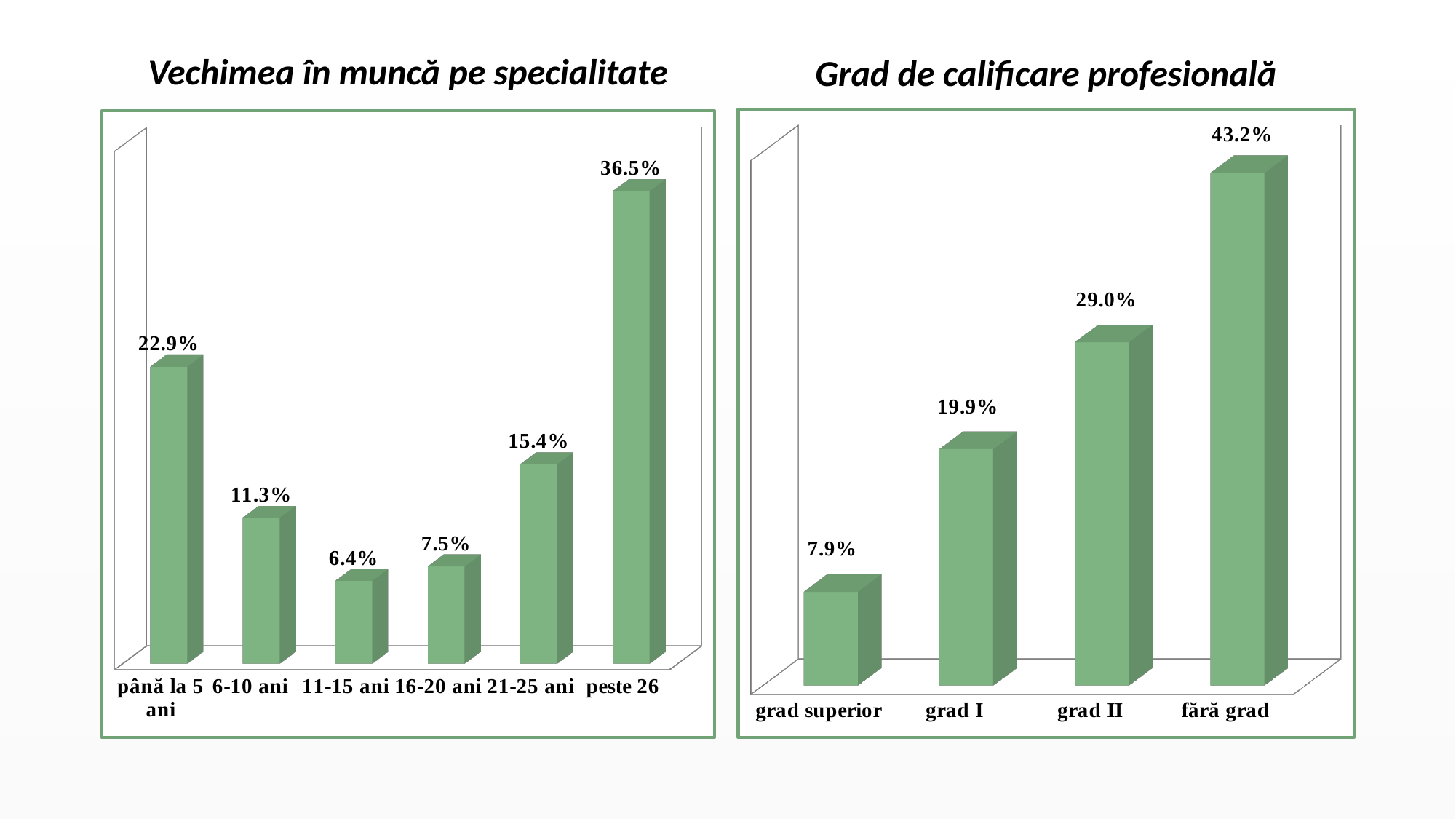
In the 'Vechimea în muncă pe specialitate' chart, how many categories are shown? 6 In the 'Grad de calificare profesională' chart, which category has the highest value? fără grad In the 'Vechimea în muncă pe specialitate' chart, what is the value for '6-10 ani'? 11.3% In the 'Grad de calificare profesională' chart, which category has the lowest value? grad superior In the 'Vechimea în muncă pe specialitate' chart, which is larger: the value for '16-20 ani' or '21-25 ani'? 21-25 ani What kind of chart is the 'Grad de calificare profesională' chart? bar chart In the 'Grad de calificare profesională' chart, do the values rise or fall from left to right? rise In the 'Grad de calificare profesională' chart, what is the difference between the values for 'fără grad' and 'grad I'? 23.3% In the 'Vechimea în muncă pe specialitate' chart, which category has the highest value? peste 26 In the 'Vechimea în muncă pe specialitate' chart, what is the difference between the values for 'peste 26' and 'până la 5 ani'? 13.6% In the 'Vechimea în muncă pe specialitate' chart, which category has the lowest value? 11-15 ani In the 'Grad de calificare profesională' chart, what is the value for 'grad II'? 29.0%